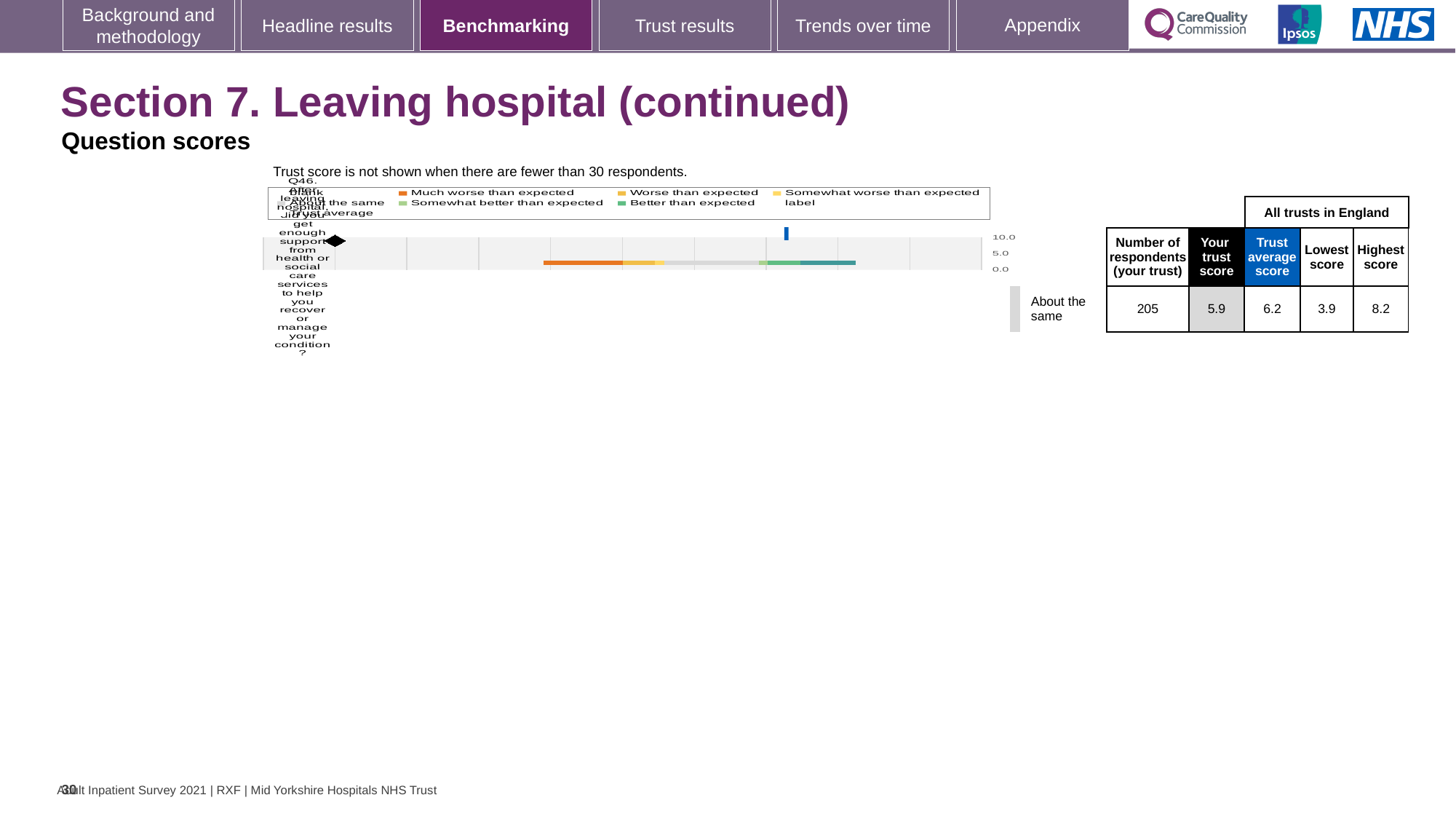
What colour is the legend entry for 'Much worse than expected'? orange What kind of chart is used to show the benchmarking result for Q46? bar chart How many questions are plotted on the chart? 1 What is the difference between the highest and lowest scores for Q46 across all trusts in England? 4.3 Which is larger for Q46, the trust score or the trust average score? trust average score What is the trust average score for Q46? 6.2 What is the trust score for Q46 (After leaving hospital, did you get enough support from health or social care services)? 5.9 What is the highest score among all trusts in England for Q46? 8.2 What is the lowest score among all trusts in England for Q46? 3.9 Which benchmark category is the trust's result for Q46 placed in? About the same Is the trust score for Q46 greater or less than 5.0 on the chart axis? greater How many respondents from the trust answered Q46? 205